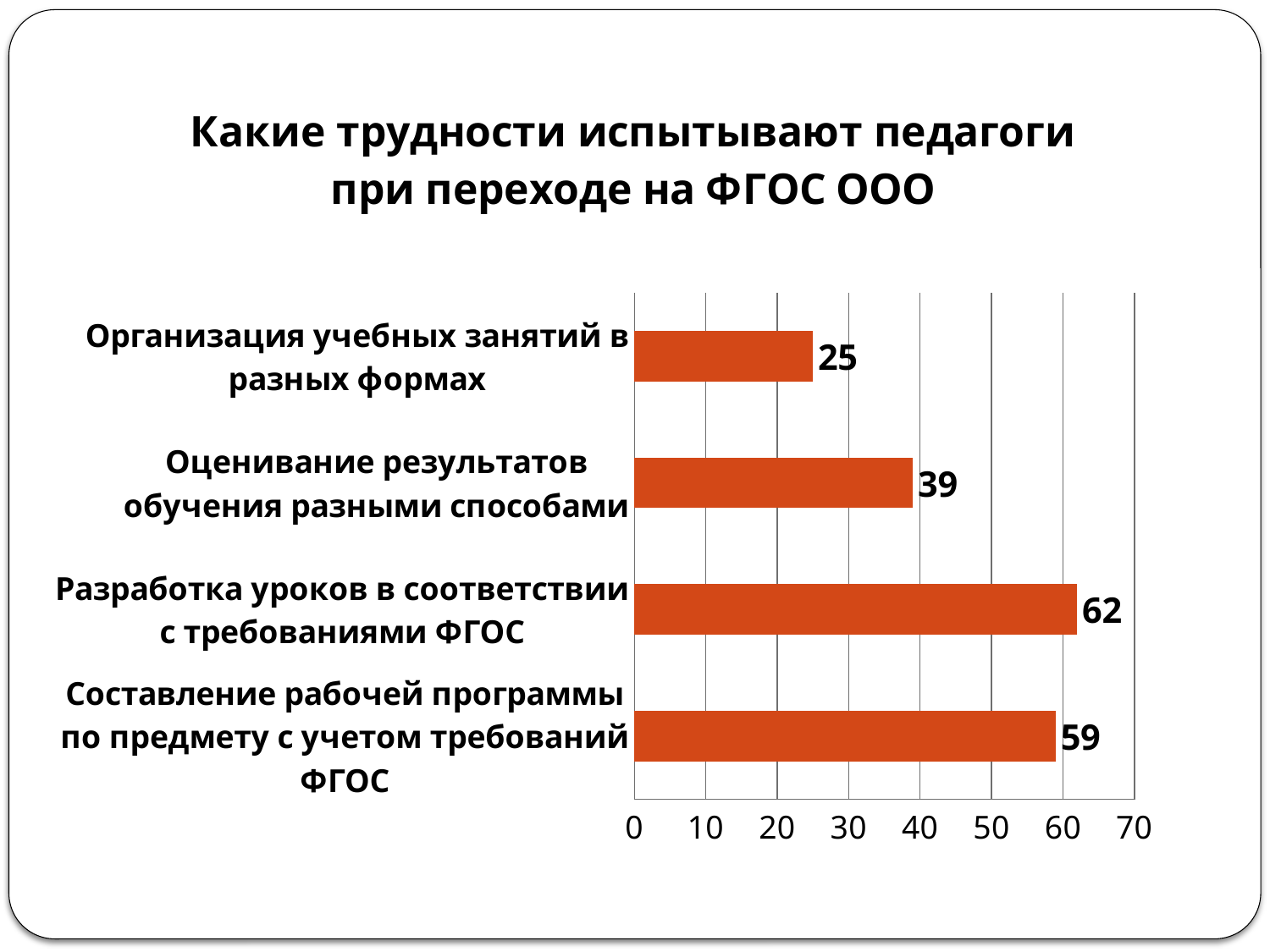
Which category has the lowest value? Организация учебных занятий в разных формах Which is larger: the value for "Оценивание результатов обучения разными способами" or for "Организация учебных занятий в разных формах"? Оценивание результатов обучения разными способами How many categories are shown in the chart? 4 What is the difference between the values for "Разработка уроков в соответствии с требованиями ФГОС" and "Составление рабочей программы по предмету с учетом требований ФГОС"? 3 What is the value for "Оценивание результатов обучения разными способами"? 39 What is the difference between the values for "Оценивание результатов обучения разными способами" and "Организация учебных занятий в разных формах"? 14 What kind of chart is shown on the slide? Bar chart What is the value for "Организация учебных занятий в разных формах"? 25 What is the title of the chart? Какие трудности испытывают педагоги при переходе на ФГОС ООО What is the value for "Составление рабочей программы по предмету с учетом требований ФГОС"? 59 Which category has the highest value? Разработка уроков в соответствии с требованиями ФГОС What is the value for "Разработка уроков в соответствии с требованиями ФГОС"? 62